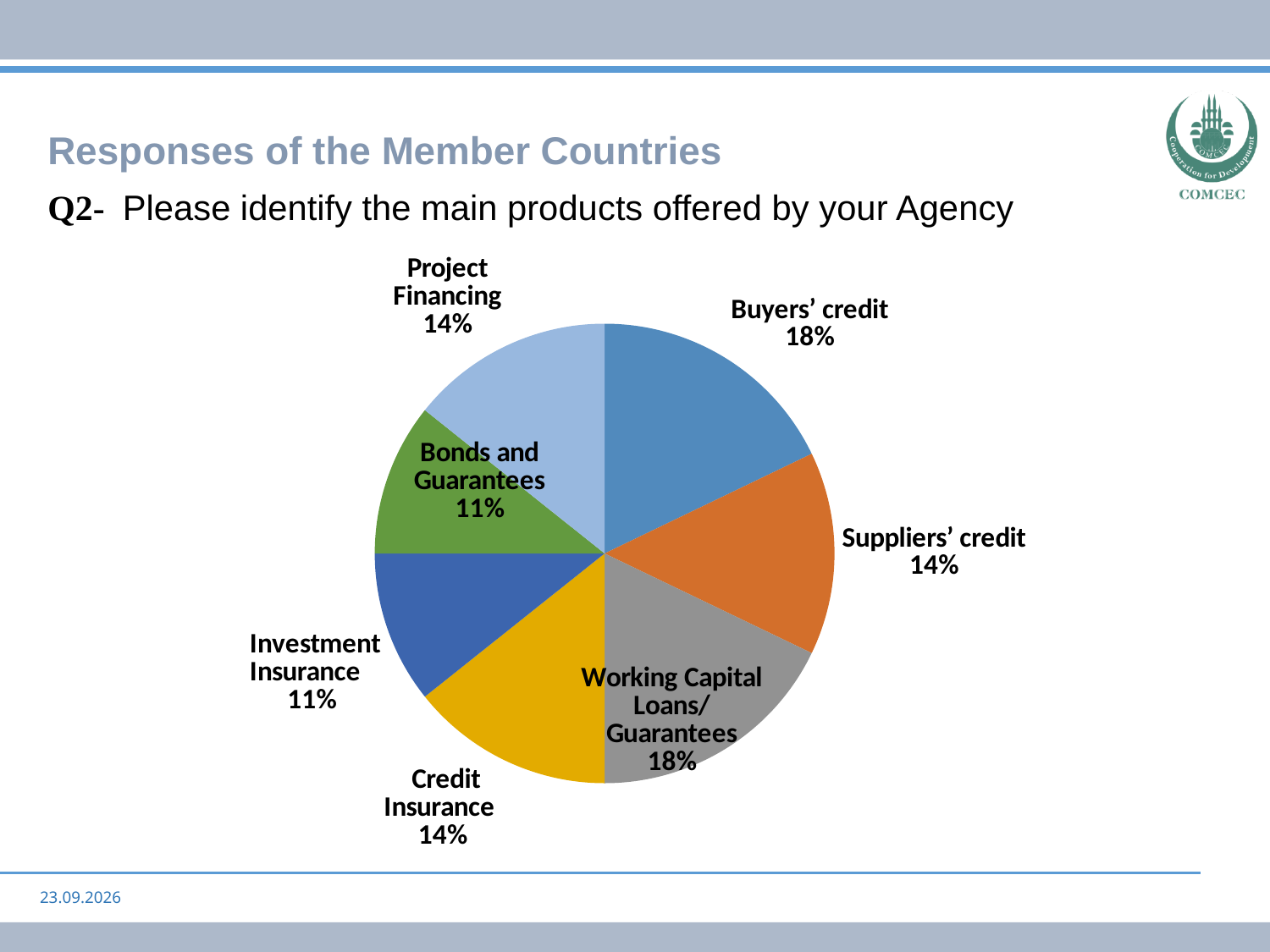
What is the value shown for Credit Insurance? 14% Which is larger, the share for Buyers' credit or the share for Suppliers' credit? Buyers' credit What share of the pie does Buyers' credit represent? 18% What is the difference in percentage points between Working Capital Loans/Guarantees and Investment Insurance? 7 What is the value shown for Suppliers' credit? 14% How many slices does the pie chart have? 7 What percentage is shown for Working Capital Loans/Guarantees? 18% What kind of chart is shown on the slide? pie chart What is the value shown for Bonds and Guarantees? 11% Which is larger, the share for Credit Insurance or the share for Bonds and Guarantees? Credit Insurance What share of the pie does Investment Insurance represent? 11% What percentage is shown for Project Financing? 14%